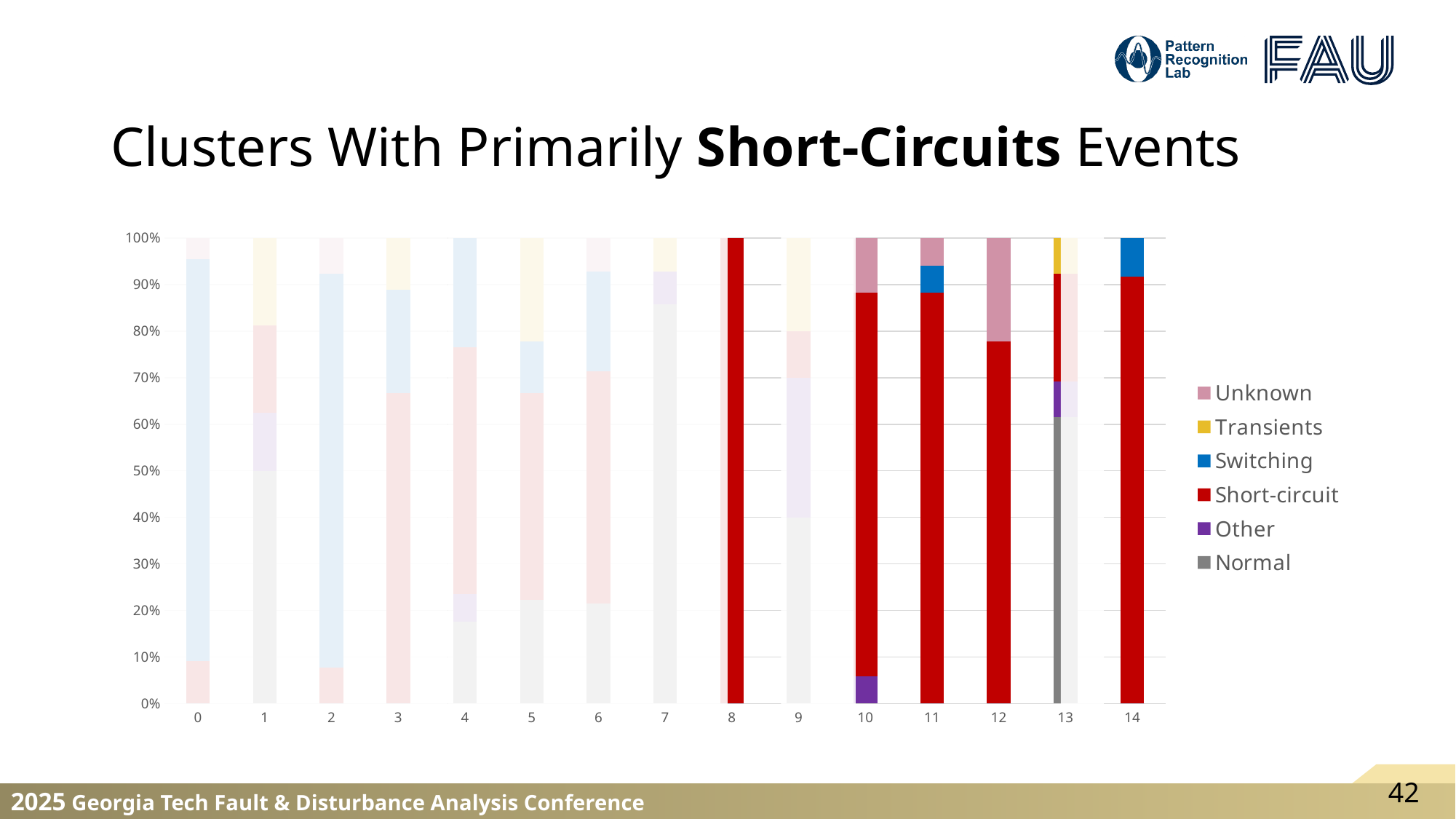
What colour represents Short-circuit in the legend? red Is the Normal share for cluster 13 greater or less than 50%? greater Which cluster has the larger Short-circuit share, cluster 8 or cluster 12? cluster 8 Is the Switching share for cluster 11 greater or less than 10%? less Which cluster's bar consists entirely of Short-circuit events? 8 What kind of chart is shown on the slide? bar chart Which cluster has the larger Unknown share, cluster 10 or cluster 12? cluster 12 Is the Short-circuit share for cluster 12 greater or less than 70%? greater How many series does the legend list? 6 What is the Short-circuit share for cluster 8? 100% How many clusters are shown along the x axis? 15